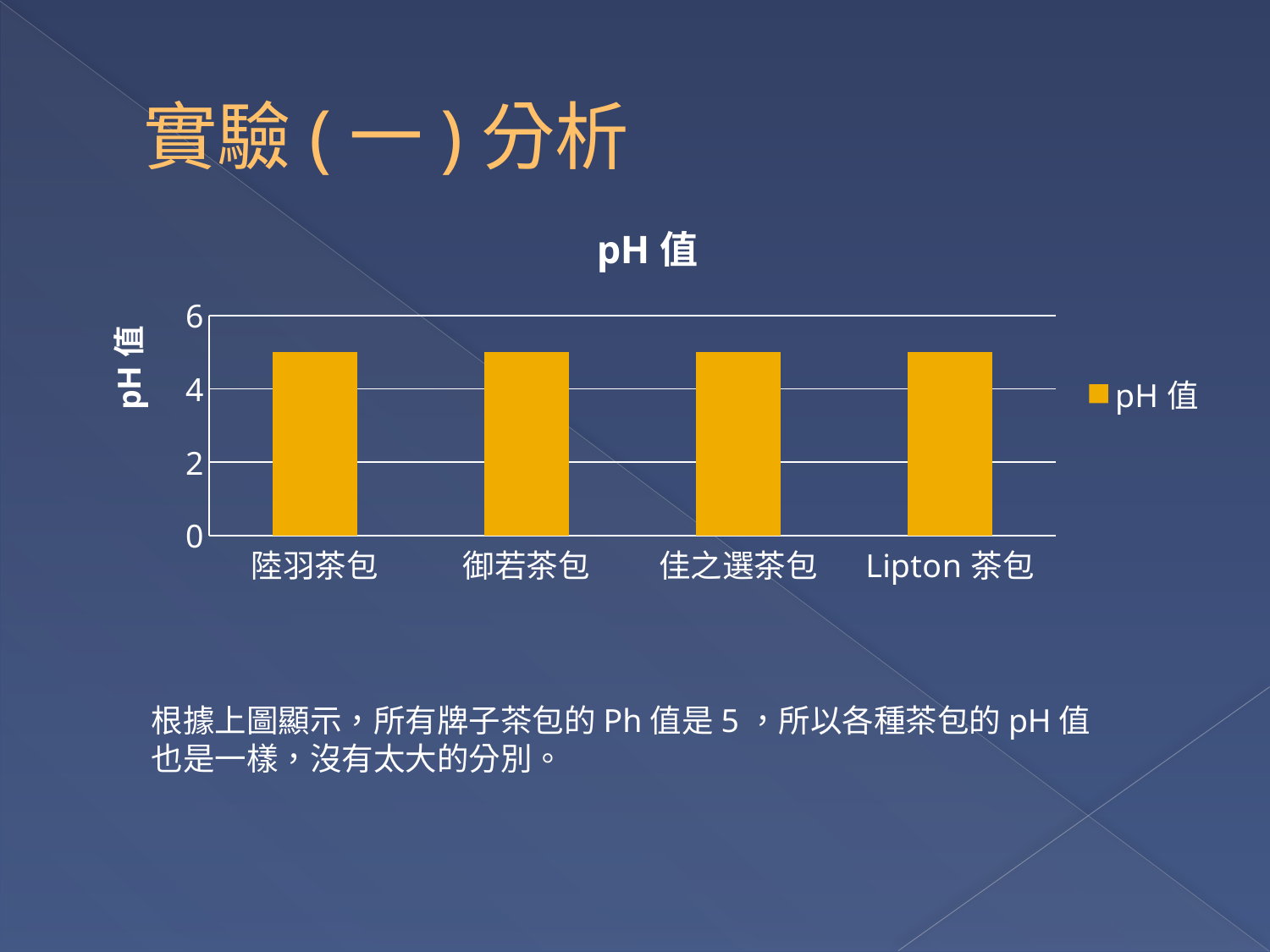
How many tea bag brands (categories) are plotted on the chart? 4 What is the title of the chart? pH 值 Is the value for 佳之選茶包 greater or less than 4? greater Is the value for Lipton 茶包 greater or less than 6? less What is the label on the vertical axis of the chart? pH 值 Is the value for 御若茶包 greater or less than 6? less What is the legend entry shown on the chart? pH 值 Do the bar values rise, fall, or stay the same across the categories from left to right? stay the same How many series does the chart legend list? 1 What kind of chart is shown on the slide? bar chart According to the slide, what is the pH value of all the tea bag brands shown in the chart? 5